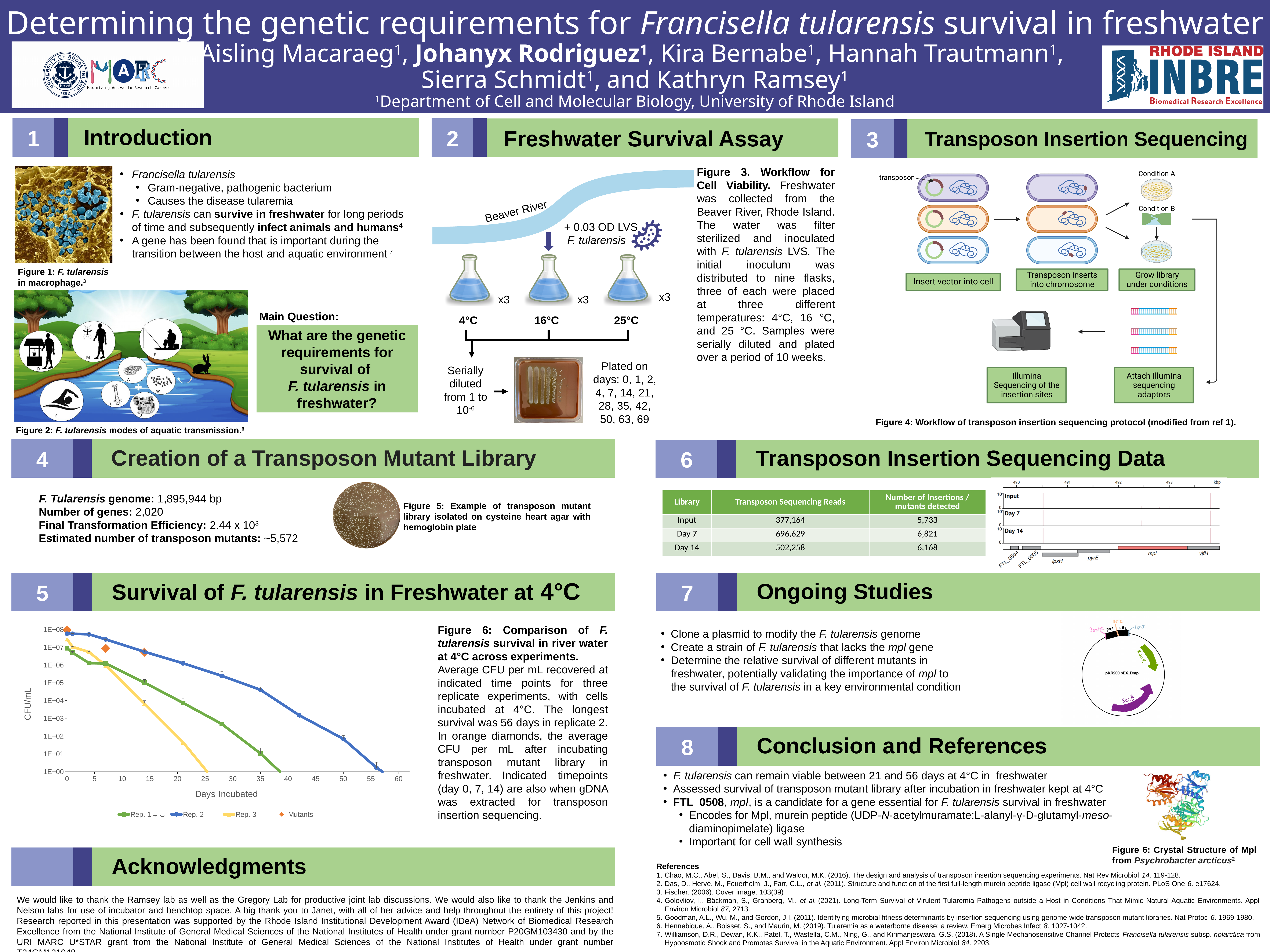
How many data points are plotted for the Mutants series in the Figure 6 survival chart? 3 What is the y-axis title of the Figure 6 survival chart? CFU/mL In the Figure 6 survival chart, which series has the lowest CFU/mL at day 21? Rep. 3 How many series does the legend of the Figure 6 survival chart list? 4 In the Figure 6 survival chart, is the CFU/mL for Mutants at day 0 greater or less than 1E+07? greater What is the x-axis title of the Figure 6 survival chart? Days Incubated In the Figure 6 survival chart, is the CFU/mL for Rep. 1 at day 28 greater or less than 1E+04? less In the Figure 6 survival chart, which series has the highest CFU/mL at day 21? Rep. 2 In the Figure 6 survival chart, at day 35, which is larger: the CFU/mL for Rep. 1 or for Rep. 2? Rep. 2 In the Figure 6 survival chart, is the CFU/mL for Rep. 2 at day 35 greater or less than 1E+03? greater What kind of chart is shown in Figure 6 (Survival of F. tularensis in Freshwater at 4°C)? line chart In the Figure 6 survival chart, do the CFU/mL values for the replicates rise or fall as days incubated increase? fall